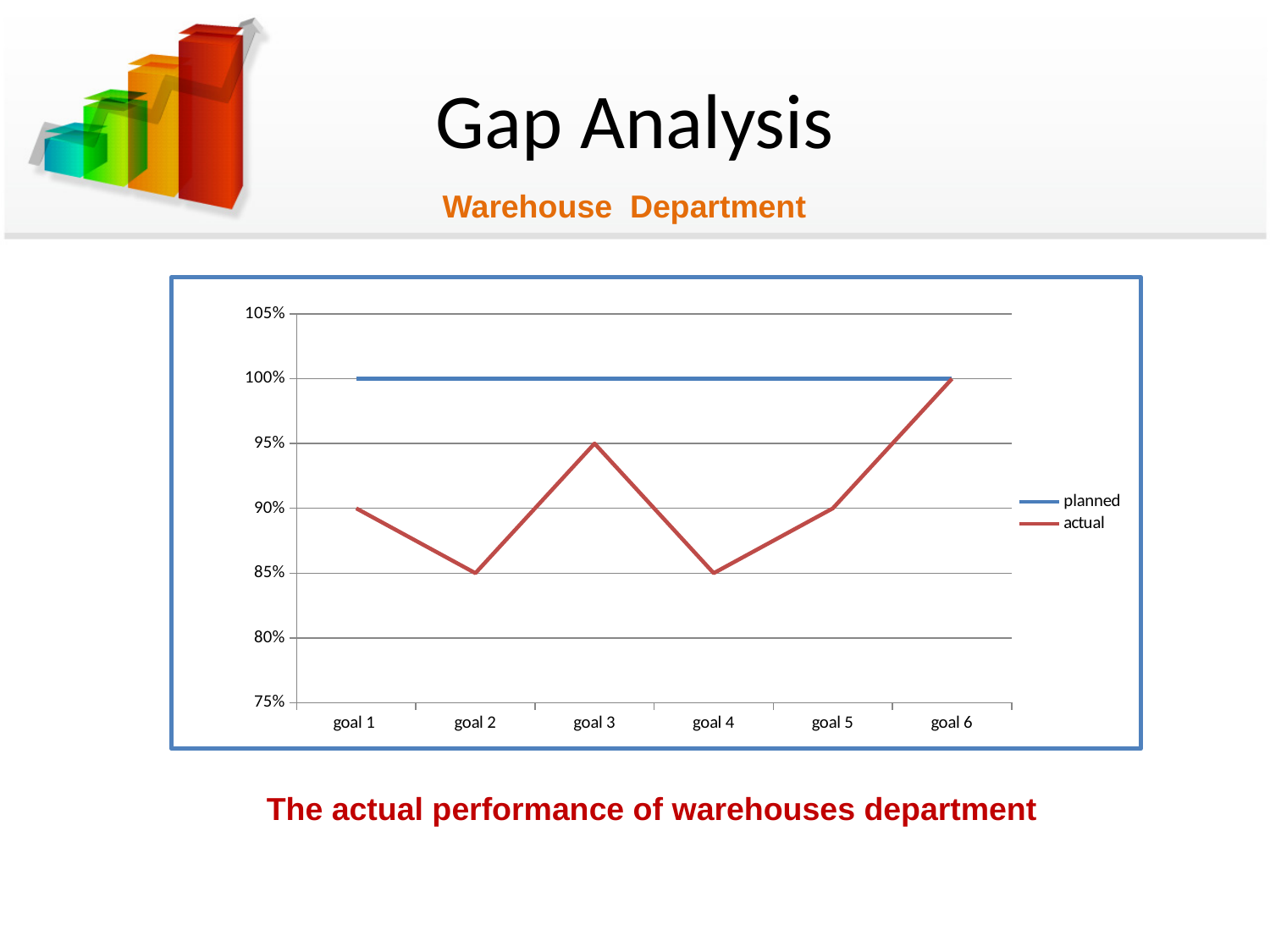
Which goal has the highest actual value? goal 6 What is the actual value for goal 3? 95% What is the actual value for goal 6? 100% How many series does the legend list? 2 Is the actual value for goal 2 greater or less than 90%? less What colour is the planned line? blue Is the actual value for goal 3 greater or less than 90%? greater Does the actual line rise or fall from goal 4 to goal 6? rise What is the planned value for goal 4? 100% What kind of chart is shown on the slide? line chart Which is larger, the actual value for goal 1 or the actual value for goal 2? goal 1 How many goals are shown on the x axis? 6